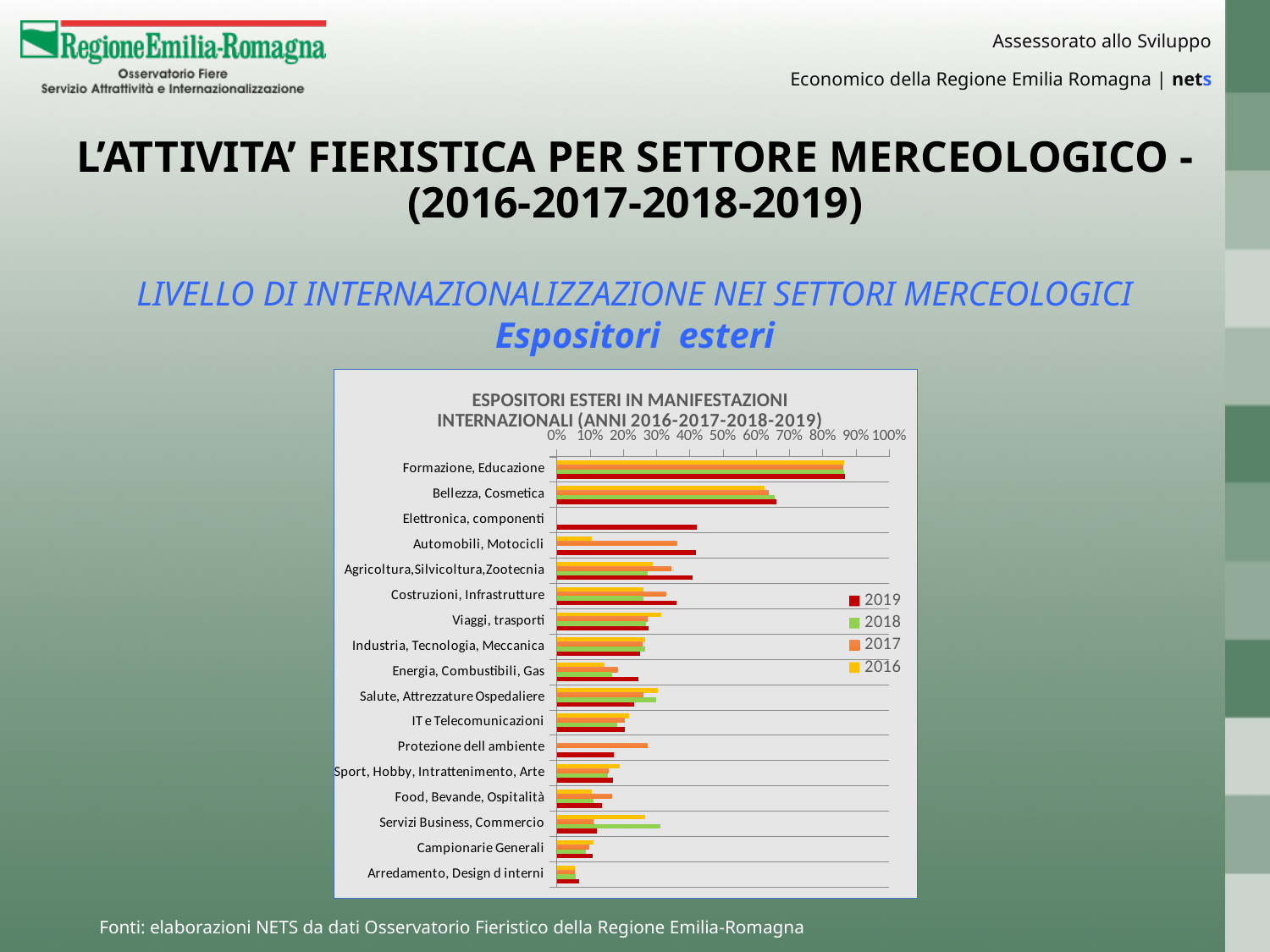
Is the 2019 value for Arredamento, Design d interni greater or less than 10%? less How many sectors (categories) are plotted in the chart? 17 What kind of chart is shown on the slide? bar chart Is the 2019 value for Formazione, Educazione greater or less than 80%? greater What is the title of the chart? ESPOSITORI ESTERI IN MANIFESTAZIONI INTERNAZIONALI (ANNI 2016-2017-2018-2019) Is the 2018 value for Servizi Business, Commercio greater or less than 20%? greater Which colour represents the 2019 series in the chart legend? red How many series does the legend of the chart list? 4 Which sector has the lowest 2019 value in the chart? Arredamento, Design d interni Which is larger: the 2019 value for Formazione, Educazione or the 2019 value for Bellezza, Cosmetica? Formazione, Educazione Which sector has the highest 2019 value in the chart? Formazione, Educazione